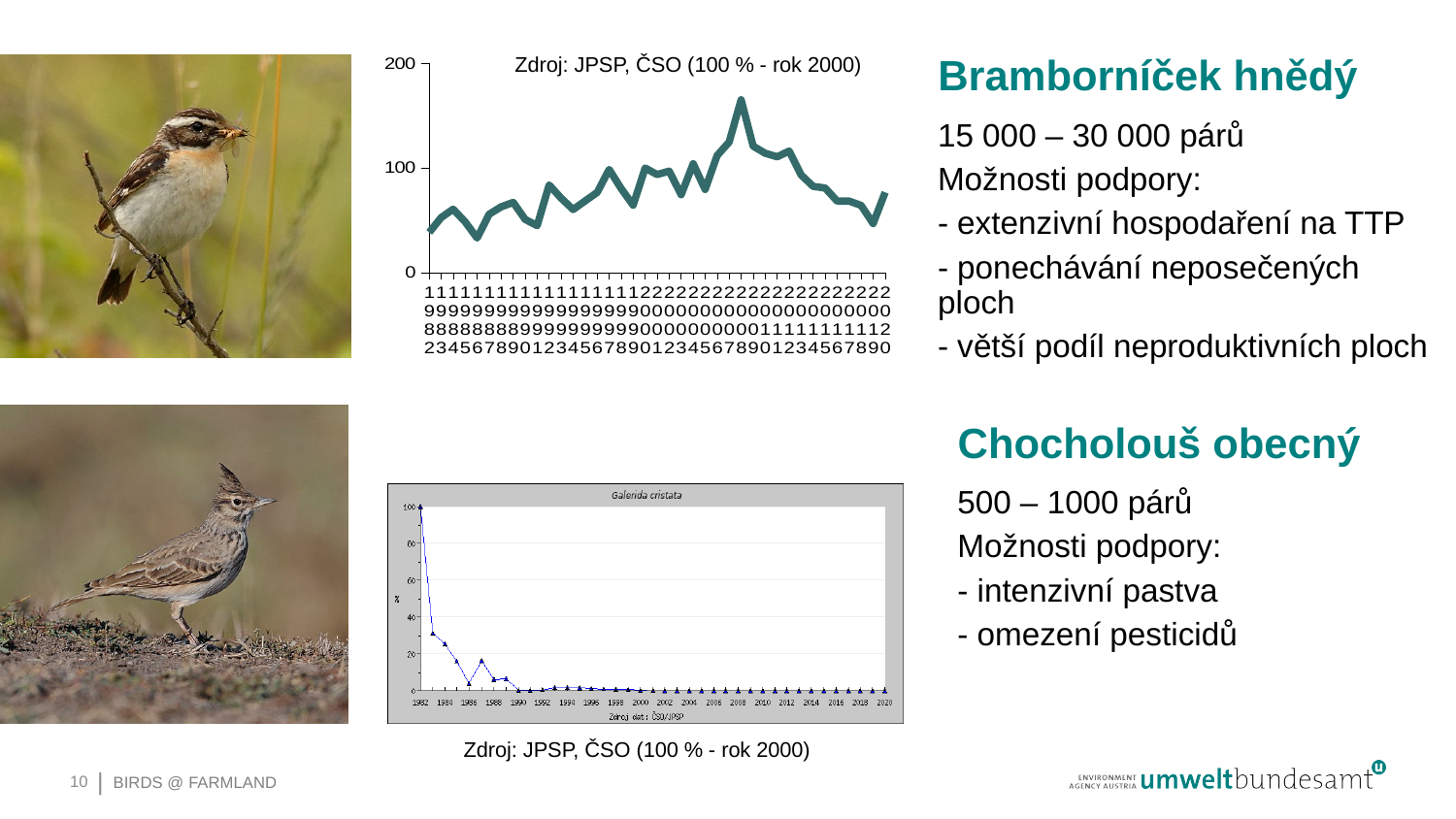
What kind of chart is the bottom chart titled Galerida cristata? line chart In the bottom chart (Galerida cristata), what is the value for 1982? 100 What kind of chart is the top chart (Zdroj: JPSP, ČSO (100 % - rok 2000))? line chart In the bottom chart (Galerida cristata), is the value for 1984 greater or less than 60? less In the top chart (Zdroj: JPSP, ČSO (100 % - rok 2000)), what is the highest value shown on the y axis? 200 In the bottom chart (Galerida cristata), which year has the highest value? 1982 In the bottom chart (Galerida cristata), which value is larger: 1982 or 2000? 1982 In the top chart (Zdroj: JPSP, ČSO (100 % - rok 2000)), is the value for the first year (1982) greater or less than 100? less In the bottom chart (Galerida cristata), do the values rise or fall from 1982 to 2020? fall In the top chart (Zdroj: JPSP, ČSO (100 % - rok 2000)), is the highest value on the line greater or less than 100? greater What is the title of the bottom chart? Galerida cristata